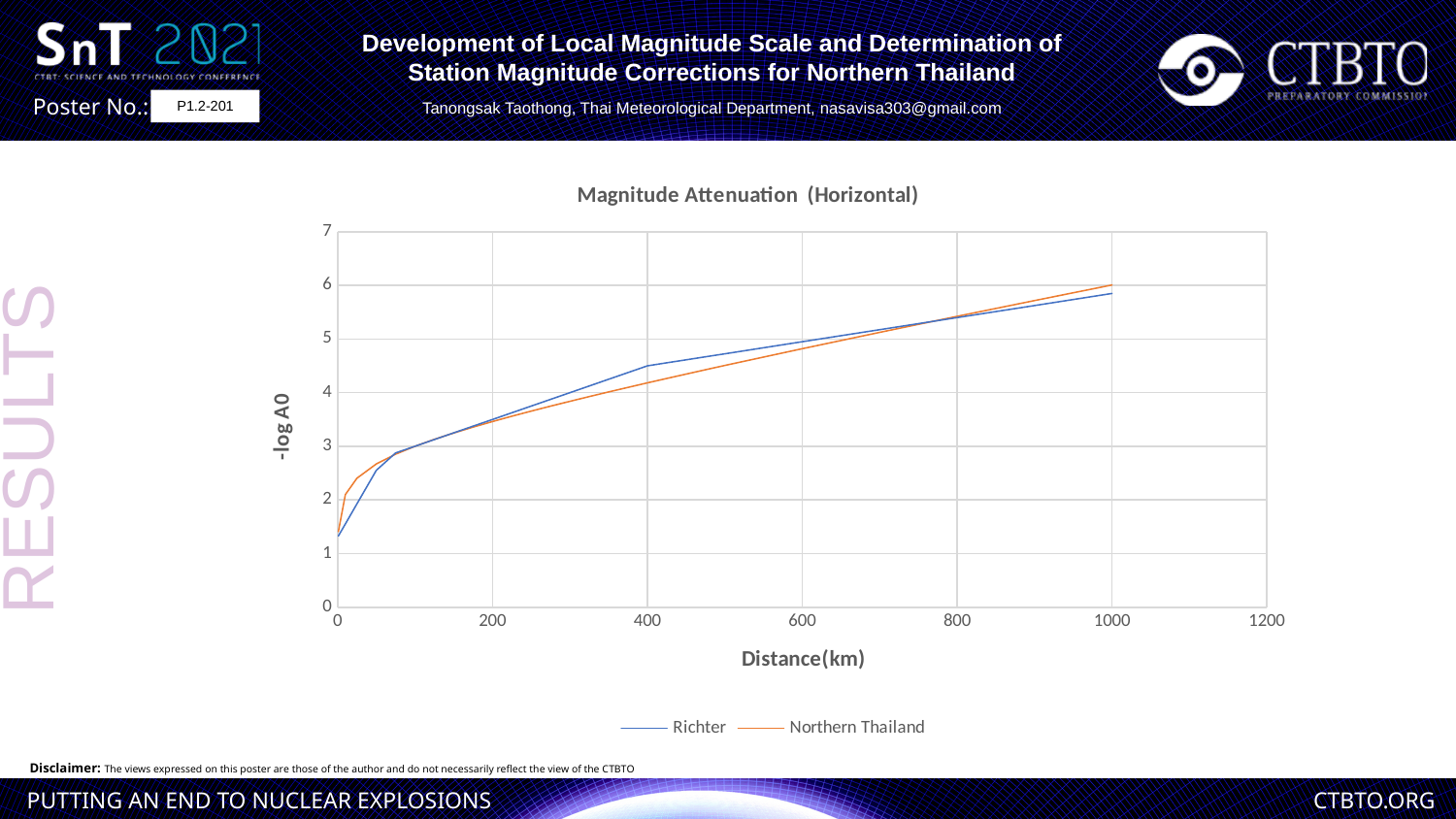
At 0 km, which series starts at the higher value, Richter or Northern Thailand? Northern Thailand Do the values of the Richter series rise or fall as distance increases? rise Is the value for Richter at 200 km greater or less than 3? greater Do the values of the Northern Thailand series rise or fall as distance increases? rise Is the value for Northern Thailand at 600 km greater or less than 5? less How many series does the legend list? 2 What is the title of the chart? Magnitude Attenuation (Horizontal) What is the label of the x axis? Distance(km) Is the value for Richter at 400 km greater or less than 4? greater What kind of chart is shown on the slide? line chart At 400 km, which series has the higher value, Richter or Northern Thailand? Richter